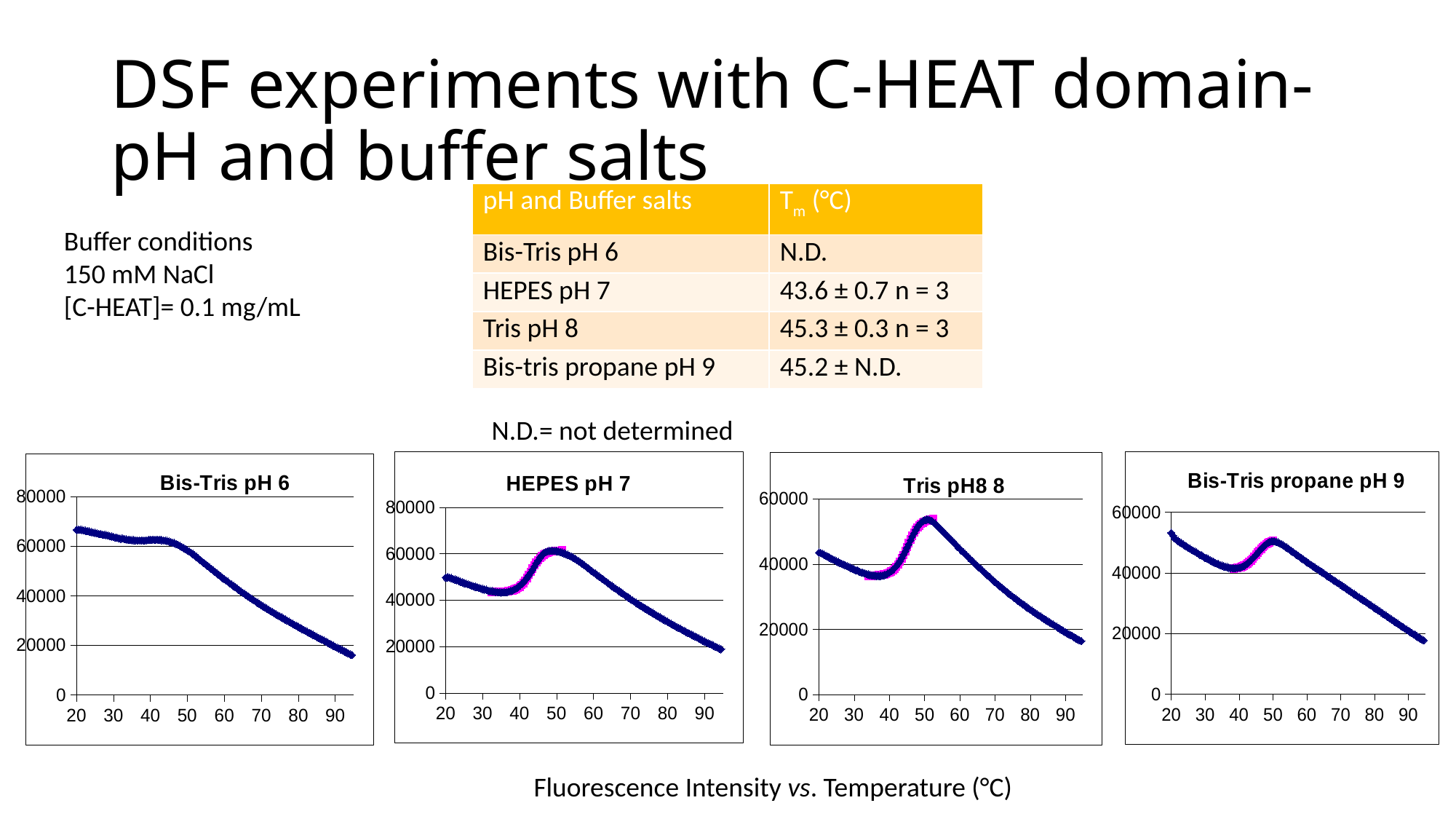
In the 'Bis-Tris pH 6' chart, is the value at 70 greater or less than 40000? less In the 'Tris pH8 8' chart, is the peak value near 50 greater or less than 60000? less In the 'HEPES pH 7' chart, which is larger, the value at 20 or the value at 90? the value at 20 What is the title of the third chart from the left? Tris pH8 8 How many charts are shown on the slide? 4 In the 'Bis-Tris pH 6' chart, do the values rise or fall as temperature increases from 50 to 90? fall In the 'HEPES pH 7' chart, is the value at 20 greater or less than 40000? greater What is the highest y-axis tick shown on the 'Bis-Tris pH 6' chart? 80000 What kind of chart is the 'Bis-Tris pH 6' chart? line chart